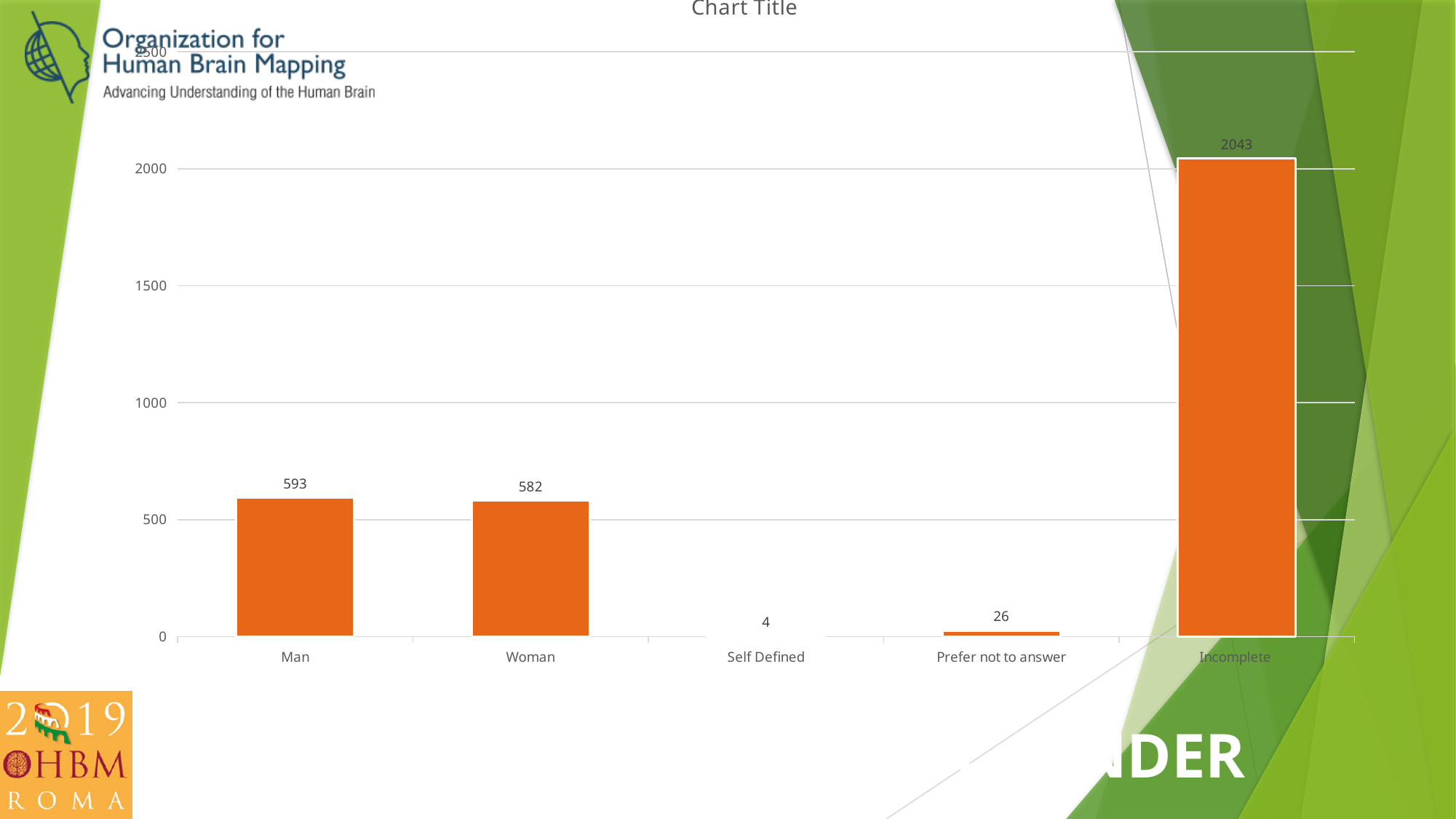
What is the value for Incomplete? 2043 Which category has the lowest value? Self Defined What is the title shown above the chart? Chart Title What is the value for Self Defined? 4 Which is larger, the value for Prefer not to answer or the value for Self Defined? Prefer not to answer Which category has the highest value? Incomplete How many categories are shown on the x axis? 5 What is the value for Prefer not to answer? 26 What is the value for Man? 593 What kind of chart is shown on the slide? Bar chart What is the value for Woman? 582 What is the difference between the values for Man and Woman? 11